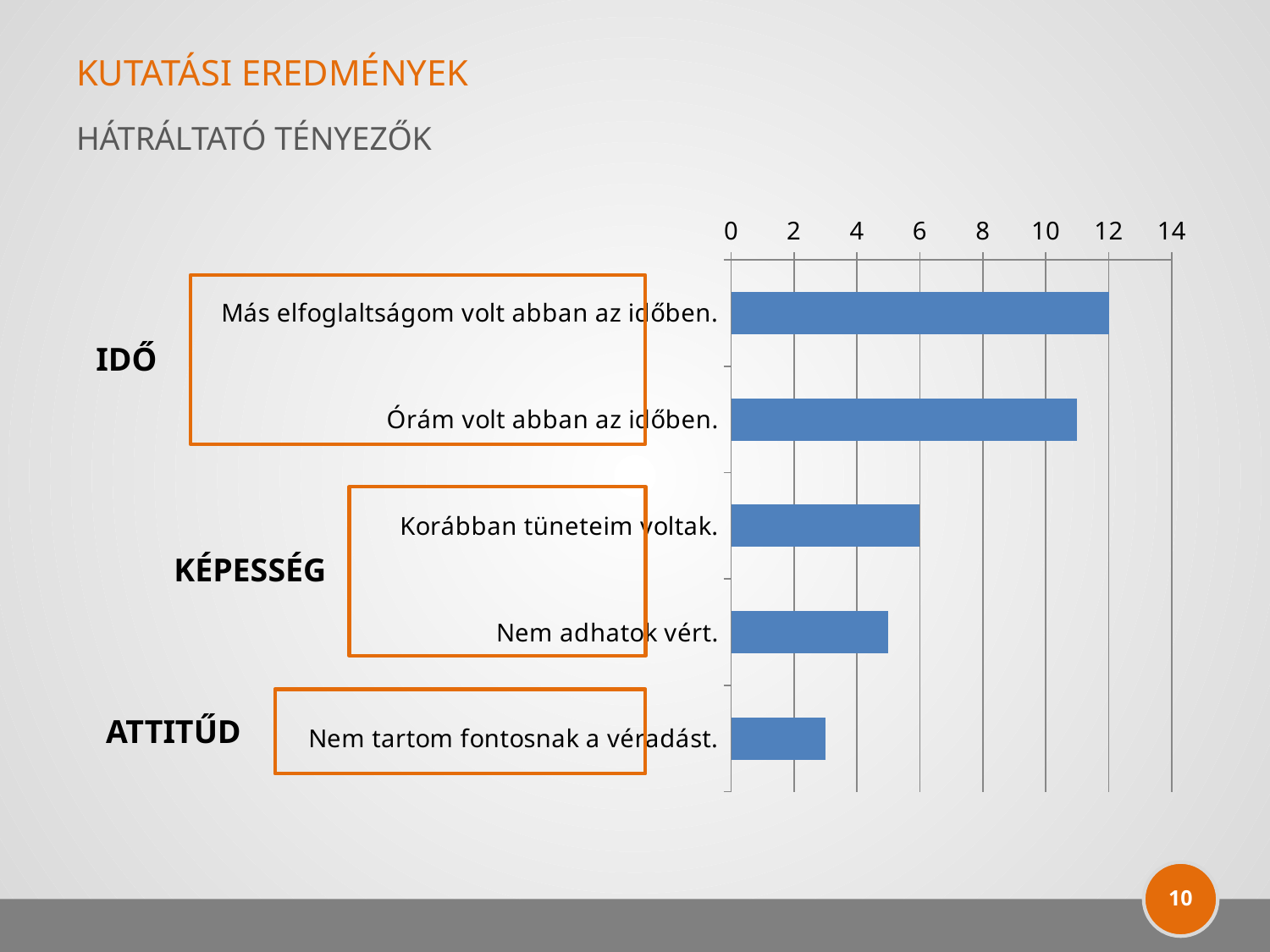
What is the value for "Más elfoglaltságom volt abban az időben."? 12 What kind of chart is shown on the slide? bar chart Which category has the highest value in the chart? Más elfoglaltságom volt abban az időben. Which group label is placed next to the categories "Korábban tüneteim voltak." and "Nem adhatok vért."? KÉPESSÉG Is the value for "Órám volt abban az időben." greater or less than 10? greater What is the value for "Korábban tüneteim voltak."? 6 Is the value for "Nem tartom fontosnak a véradást." greater or less than 4? less Which category has the lowest value in the chart? Nem tartom fontosnak a véradást. What is the highest tick value shown on the chart's value axis? 14 How many categories (bars) does the chart show? 5 Is the value for "Nem adhatok vért." greater or less than 6? less Which is larger: the value for "Korábban tüneteim voltak." or the value for "Nem tartom fontosnak a véradást."? Korábban tüneteim voltak.